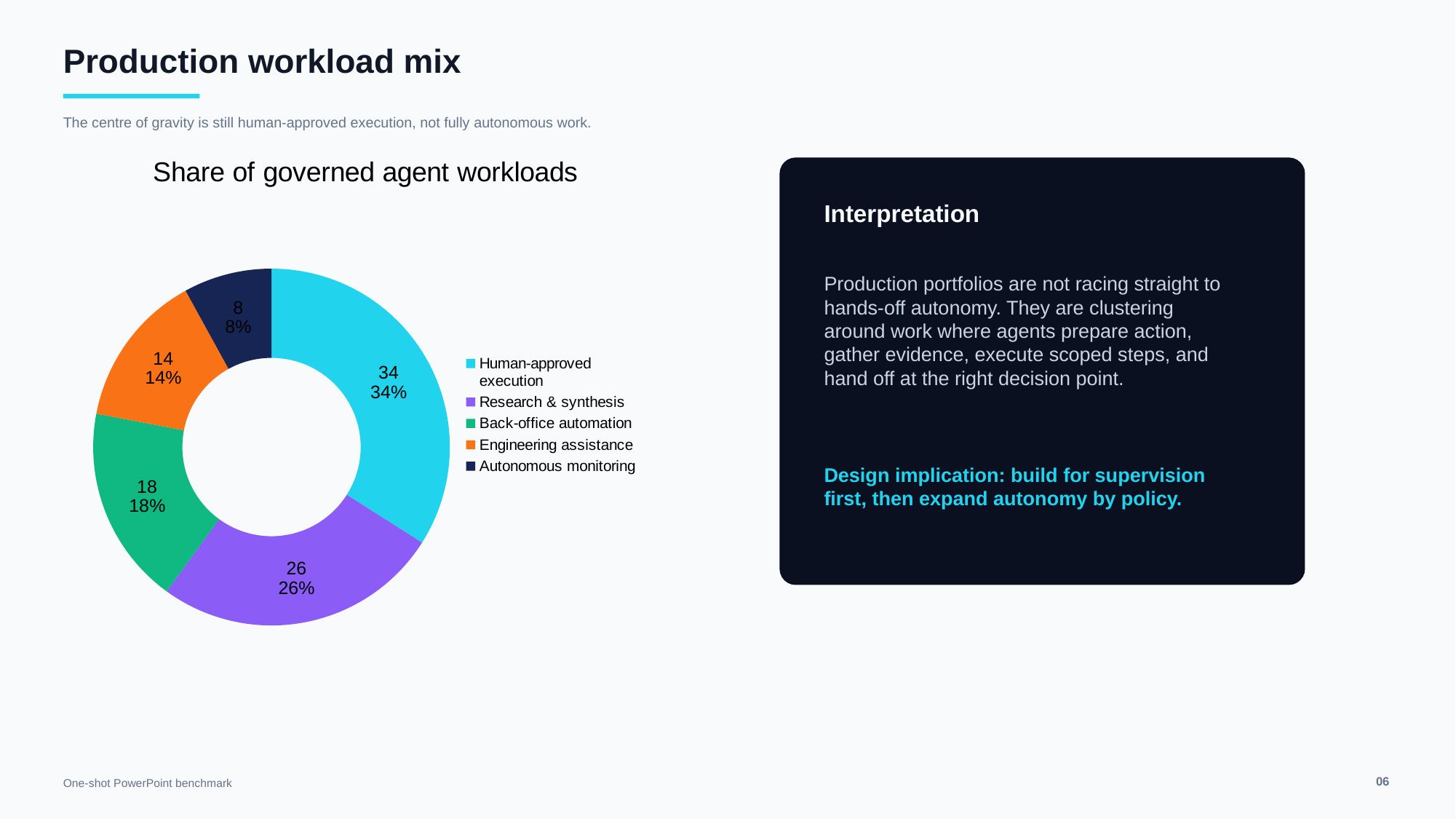
What percentage share does Research & synthesis have? 26% What colour is the Autonomous monitoring segment? Dark navy What is the title of the chart? Share of governed agent workloads What percentage share does Engineering assistance have? 14% What value is shown for Back-office automation? 18 What kind of chart is shown on the slide? Doughnut chart What is the difference between the values for Human-approved execution and Research & synthesis? 8 What value is shown for Human-approved execution? 34 Which is larger, Back-office automation or Engineering assistance? Back-office automation Which category has the smallest share? Autonomous monitoring How many categories does the chart show? 5 Which category has the largest share? Human-approved execution